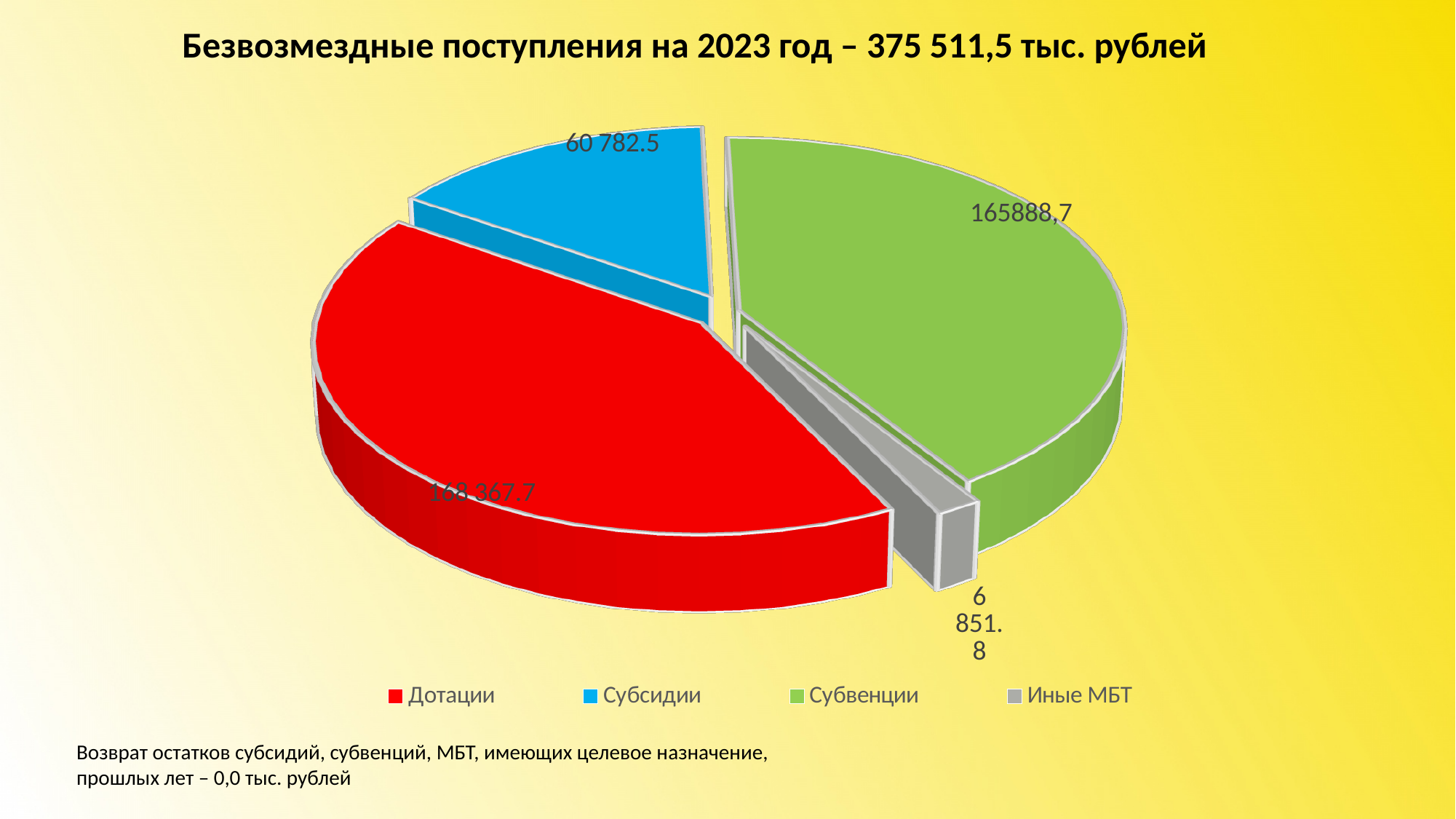
What is the value for Субвенции? 165888,7 What is the difference between the values for Субсидии and Иные МБТ? 53 930.7 What is the value for Субсидии? 60 782.5 Which category has the smallest slice of the pie? Иные МБТ Which category has the largest slice of the pie? Дотации What is the value for Дотации? 168 367.7 What total amount is stated in the chart title for 2023? 375 511,5 тыс. рублей How many categories are shown in the pie chart? 4 What is the value for Иные МБТ? 6 851.8 What kind of chart is shown on the slide? Pie chart Which is larger, the value for Субсидии or the value for Иные МБТ? Субсидии What colour is the Субвенции slice? Green